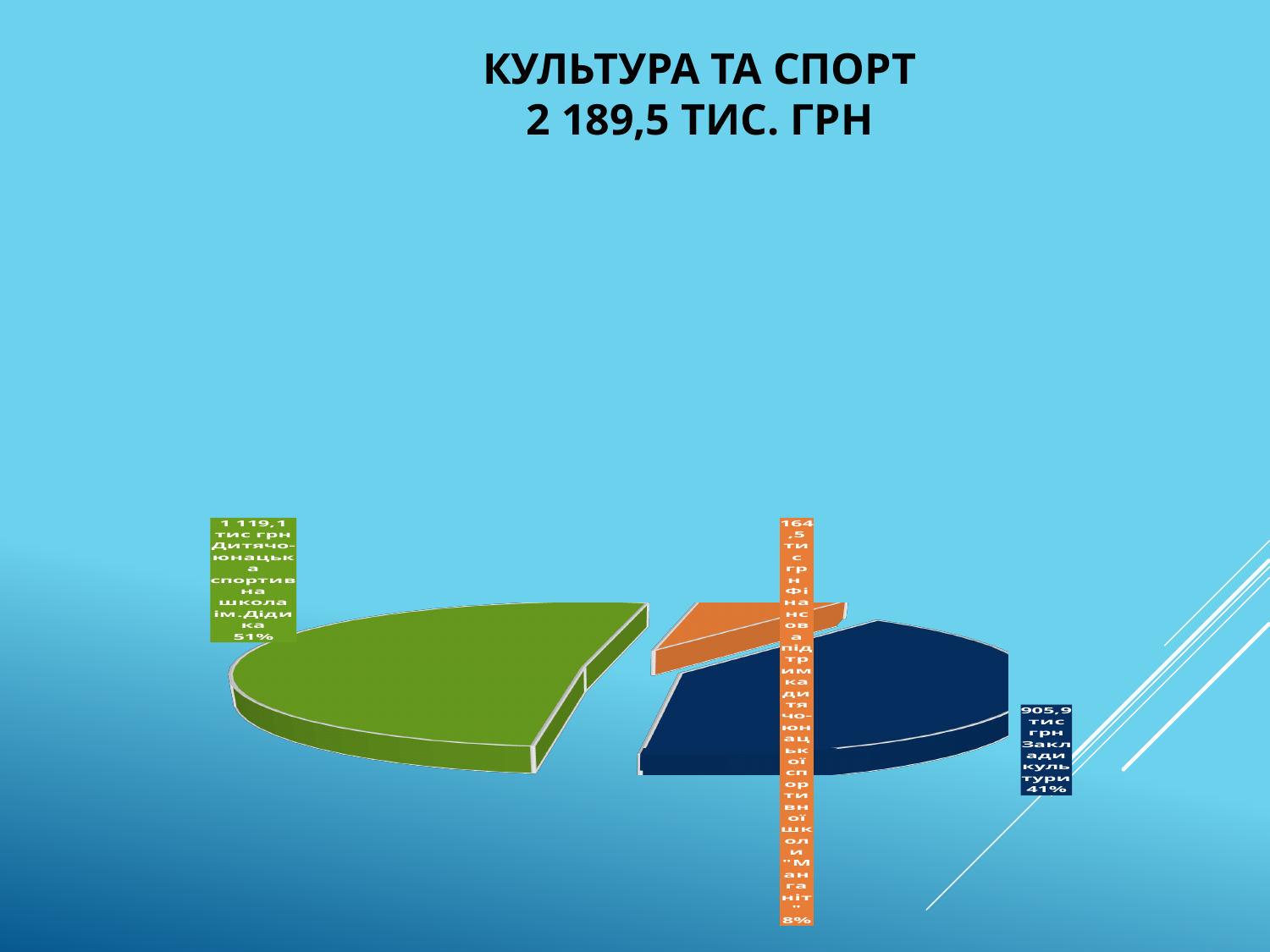
Which category has the smallest slice of the pie? Фінансова підтримка дитячо-юнацької спортивної школи "Манганіт" What is the title of the chart? КУЛЬТУРА ТА СПОРТ 2 189,5 ТИС. ГРН What is the value for Фінансова підтримка дитячо-юнацької спортивної школи "Манганіт"? 164,5 тис грн How many slices does the pie chart have? 3 What is the value for Заклади культури? 905,9 тис грн What kind of chart is shown on the slide? pie chart What is the value for Дитячо-юнацька спортивна школа ім.Дідика? 1 119,1 тис грн What share of the pie does Дитячо-юнацька спортивна школа ім.Дідика represent? 51% Which is larger: the value for Заклади культури or the value for Фінансова підтримка дитячо-юнацької спортивної школи "Манганіт"? Заклади культури What is the difference between the value for Дитячо-юнацька спортивна школа ім.Дідика and the value for Заклади культури? 213,2 тис грн Which category has the largest slice of the pie? Дитячо-юнацька спортивна школа ім.Дідика What share of the pie does Заклади культури represent? 41%